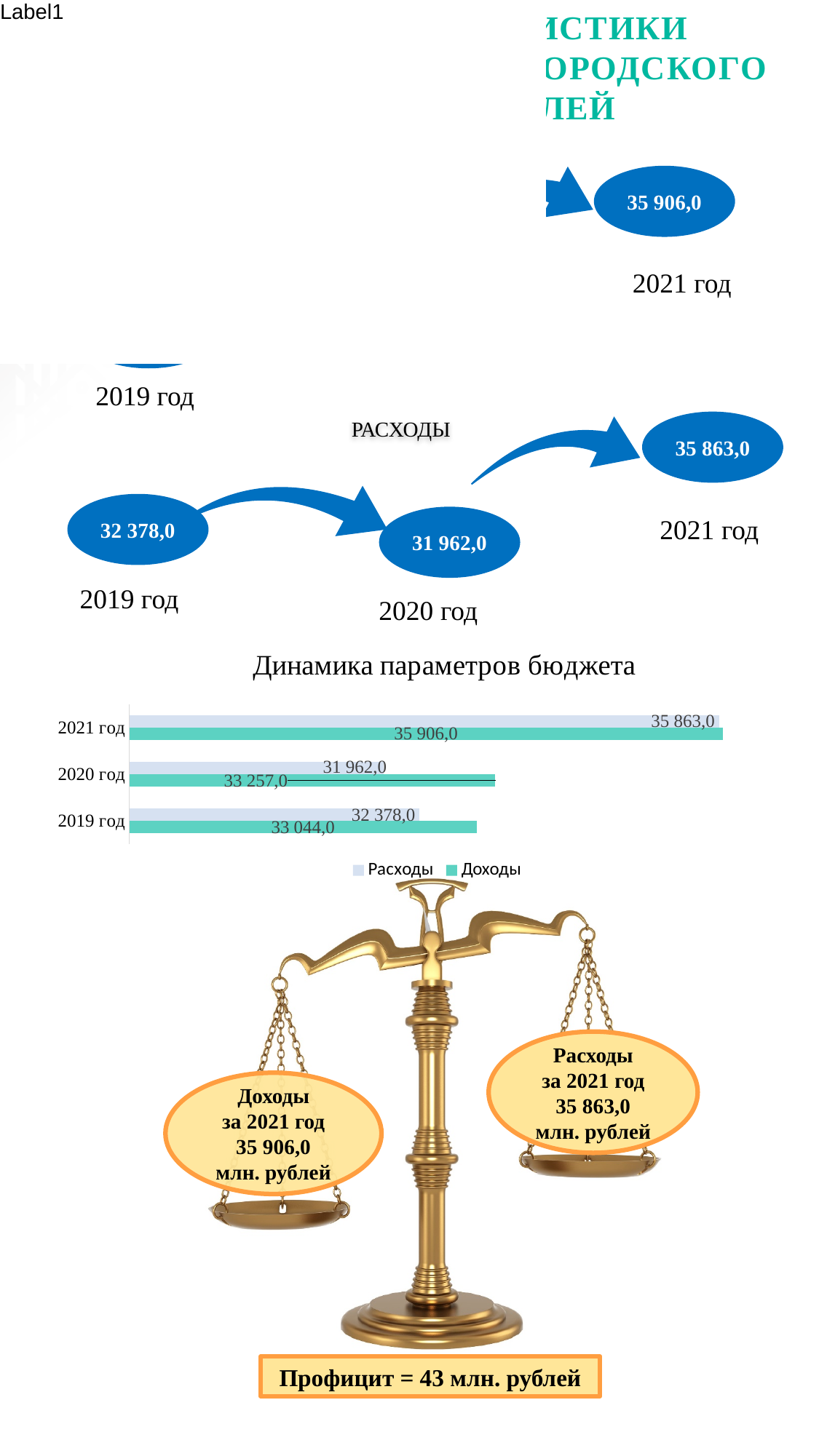
What type of chart is "Динамика параметров бюджета"? bar chart In the chart "Динамика параметров бюджета", which is larger for 2020 год: Доходы or Расходы? Доходы In the chart "Динамика параметров бюджета", what is the difference between Доходы and Расходы for 2021 год? 43,0 In the chart "Динамика параметров бюджета", which year has the lowest value of Расходы? 2020 год In the chart "Динамика параметров бюджета", what is the value of Доходы for 2019 год? 33 044,0 In the chart "Динамика параметров бюджета", what is the difference between Доходы and Расходы for 2020 год? 1 295,0 In the chart "Динамика параметров бюджета", what is the value of Расходы for 2019 год? 32 378,0 In the chart "Динамика параметров бюджета", what is the value of Доходы for 2021 год? 35 906,0 In the chart "Динамика параметров бюджета", what is the value of Расходы for 2020 год? 31 962,0 How many years (categories) are shown in the chart "Динамика параметров бюджета"? 3 In the chart "Динамика параметров бюджета", which year has the highest value of Доходы? 2021 год How many series does the legend of the chart "Динамика параметров бюджета" list? 2